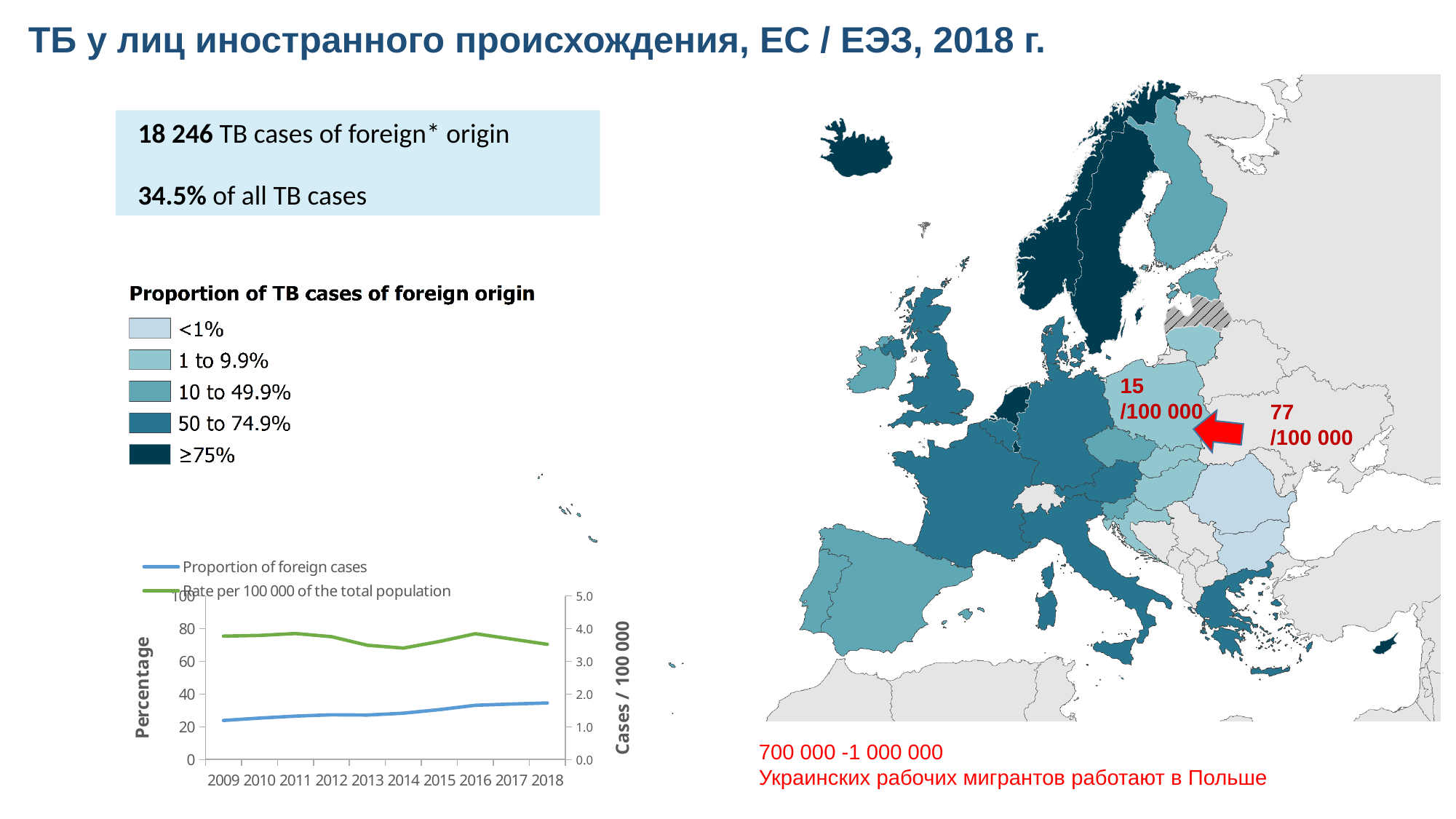
How many series does the legend of the line chart at the bottom left list? 2 In the line chart at the bottom left, which year has the lowest value for 'Proportion of foreign cases'? 2009 What is the title of the left vertical axis of the line chart at the bottom left? Percentage How many years are shown on the x axis of the line chart at the bottom left? 10 In the line chart at the bottom left, which is larger: the 'Proportion of foreign cases' value for 2018 or for 2009? 2018 What kind of chart is shown at the bottom left of the slide? line chart In the line chart at the bottom left, is the 'Proportion of foreign cases' value for 2018 greater or less than 20? greater In the line chart at the bottom left, is the 'Rate per 100 000 of the total population' value for 2014 greater or less than 4.0? less In the line chart at the bottom left, is the 'Rate per 100 000 of the total population' value for 2016 greater or less than 3.0? greater In the line chart at the bottom left, does the 'Proportion of foreign cases' line rise or fall from 2009 to 2018? rise In the line chart at the bottom left, which year has the highest value for 'Proportion of foreign cases'? 2018